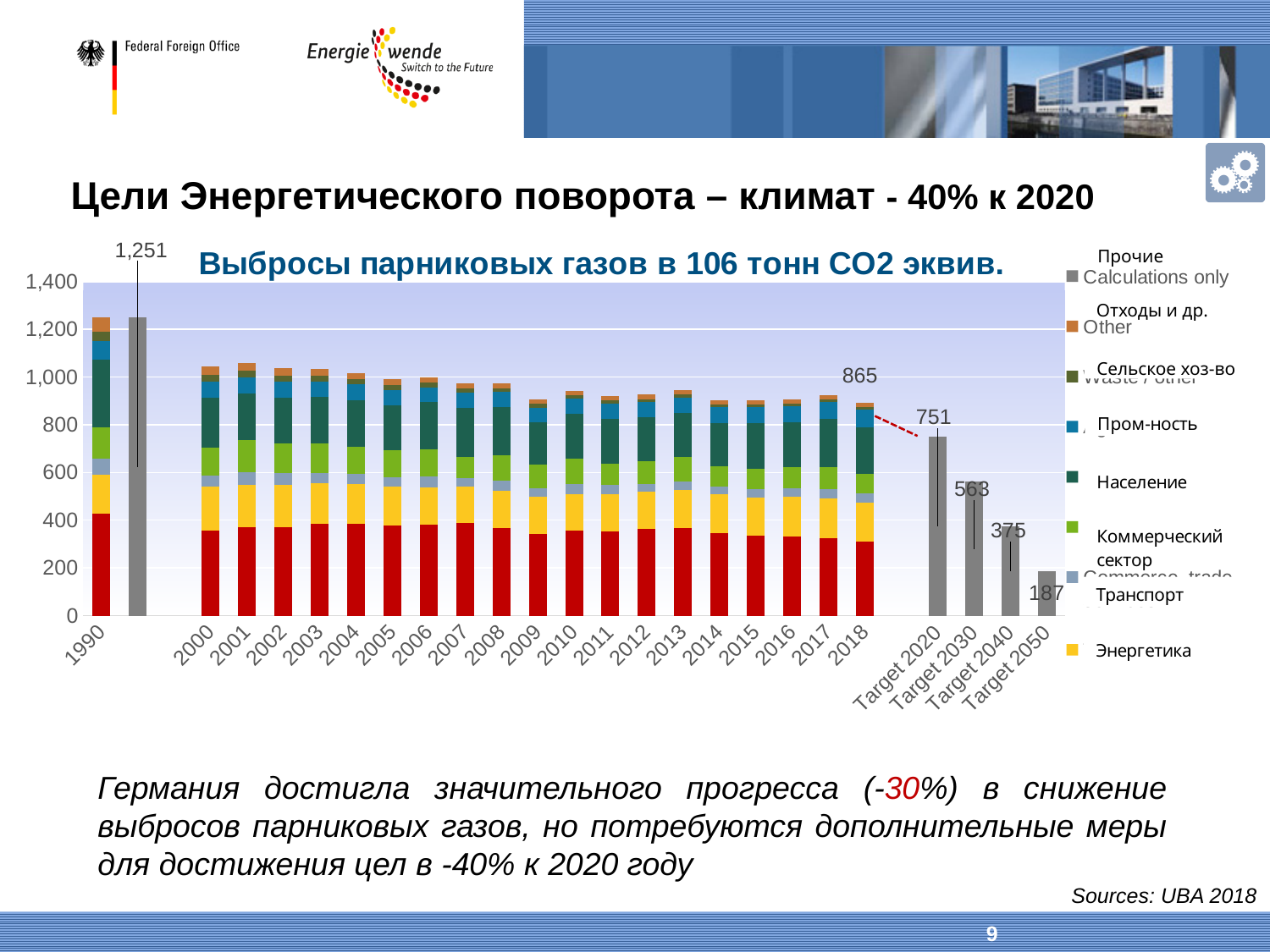
What value is shown for Target 2050? 187 What kind of chart is shown on the slide? Bar chart Which is larger, the value for Target 2030 or the value for Target 2040? Target 2030 What value is shown for Target 2030? 563 What is the difference between the 2018 value and the Target 2020 value? 114 What value is labelled for 2018? 865 What is the total greenhouse gas emissions value shown for 1990? 1,251 What is the title of the chart? Выбросы парниковых газов в 106 тонн CO2 эквив. Is the total value for 2009 greater or less than 1,000? less What is the difference between the 1990 value and the 2018 value? 386 Do the target values rise or fall from Target 2020 to Target 2050? Fall What value is shown for Target 2020? 751